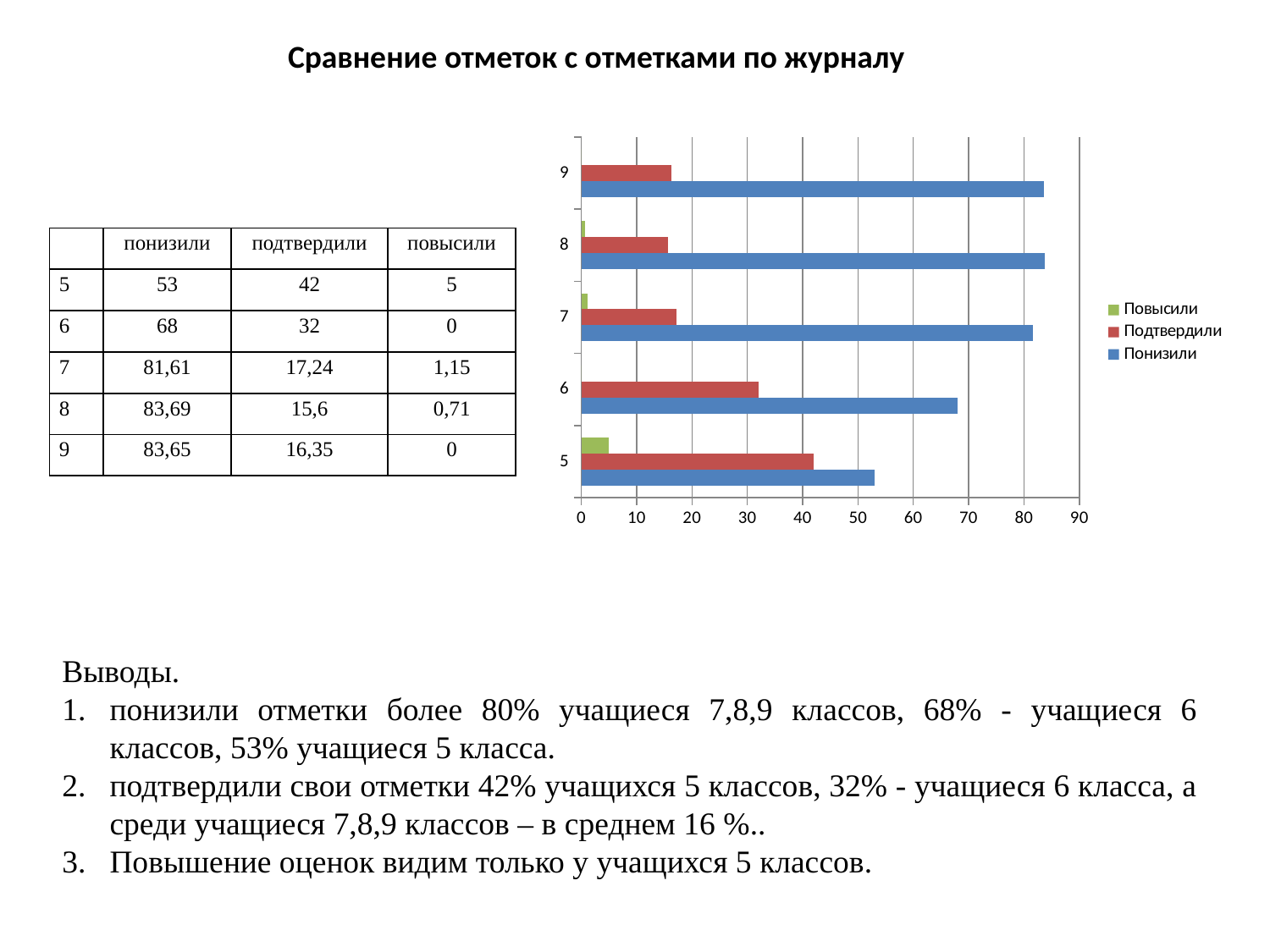
How many categories (classes) are plotted on the chart? 5 Which series is shown in blue on the chart? Понизили How many series does the chart legend list? 3 Which class has the highest value for Подтвердили? 5 What is the difference between Понизили for class 6 and Понизили for class 5? 15 What is the value of Подтвердили for class 7? 17,24 Which class has the lowest value for Понизили? 5 What is the value of Повысили for class 8? 0,71 Is the value of Понизили for class 6 greater or less than 60? greater What kind of chart is shown on the slide? bar chart Which is larger for class 6: Понизили or Подтвердили? Понизили What is the value of Понизили for class 5? 53